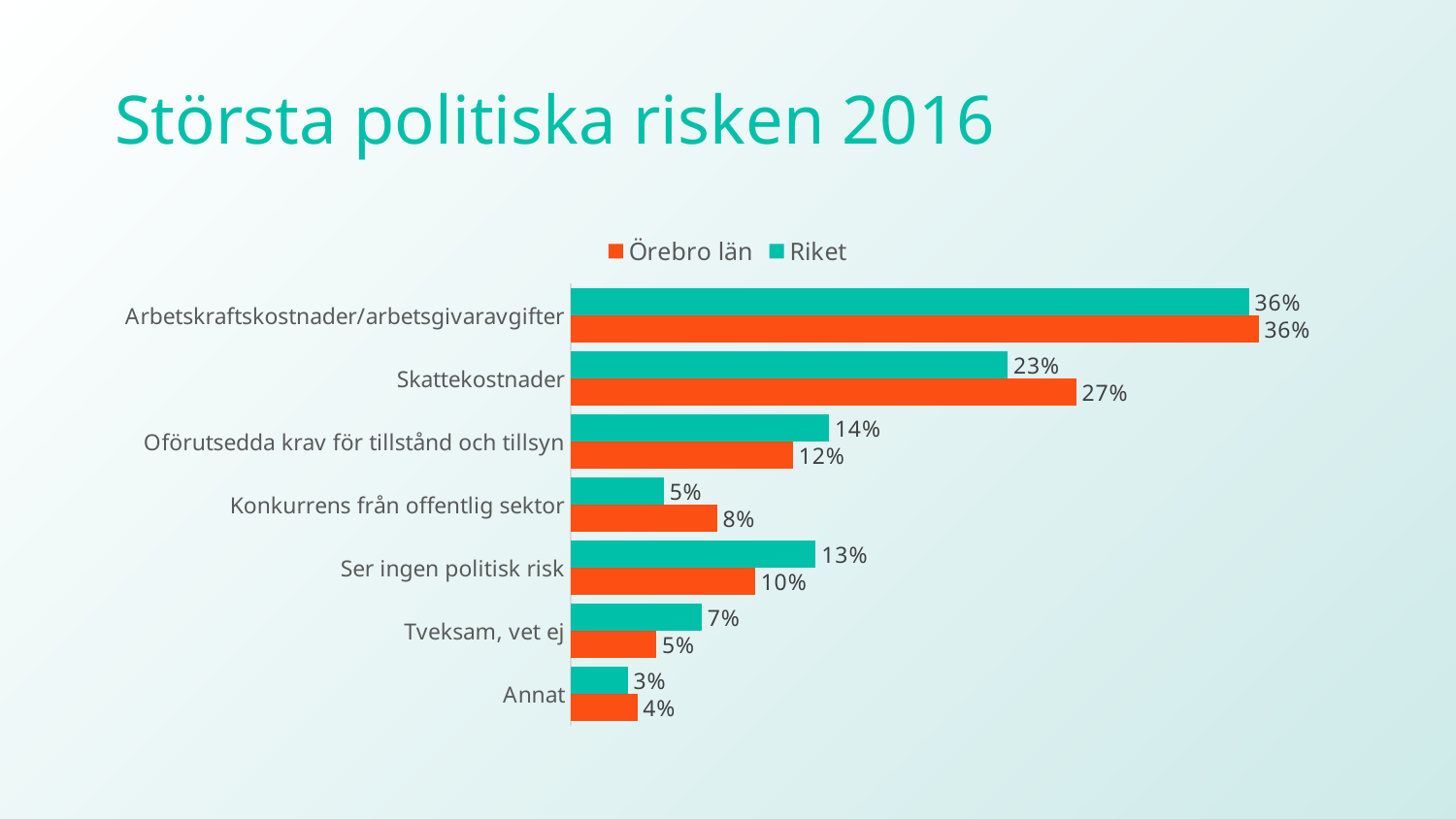
How many series does the legend list? 2 What is the Örebro län value for Skattekostnader? 27% Which is larger for Oförutsedda krav för tillstånd och tillsyn: Örebro län or Riket? Riket How many categories are shown in the chart? 7 What kind of chart is shown on the slide? Bar chart Which category has the lowest Örebro län value? Annat What is the Riket value for Konkurrens från offentlig sektor? 5% Which category has the highest Riket value? Arbetskraftskostnader/arbetsgivaravgifter Which is larger for Konkurrens från offentlig sektor: Örebro län or Riket? Örebro län What is the difference between the Örebro län and Riket values for Skattekostnader? 4% What is the Riket value for Ser ingen politisk risk? 13% What is the difference between the Riket and Örebro län values for Ser ingen politisk risk? 3%